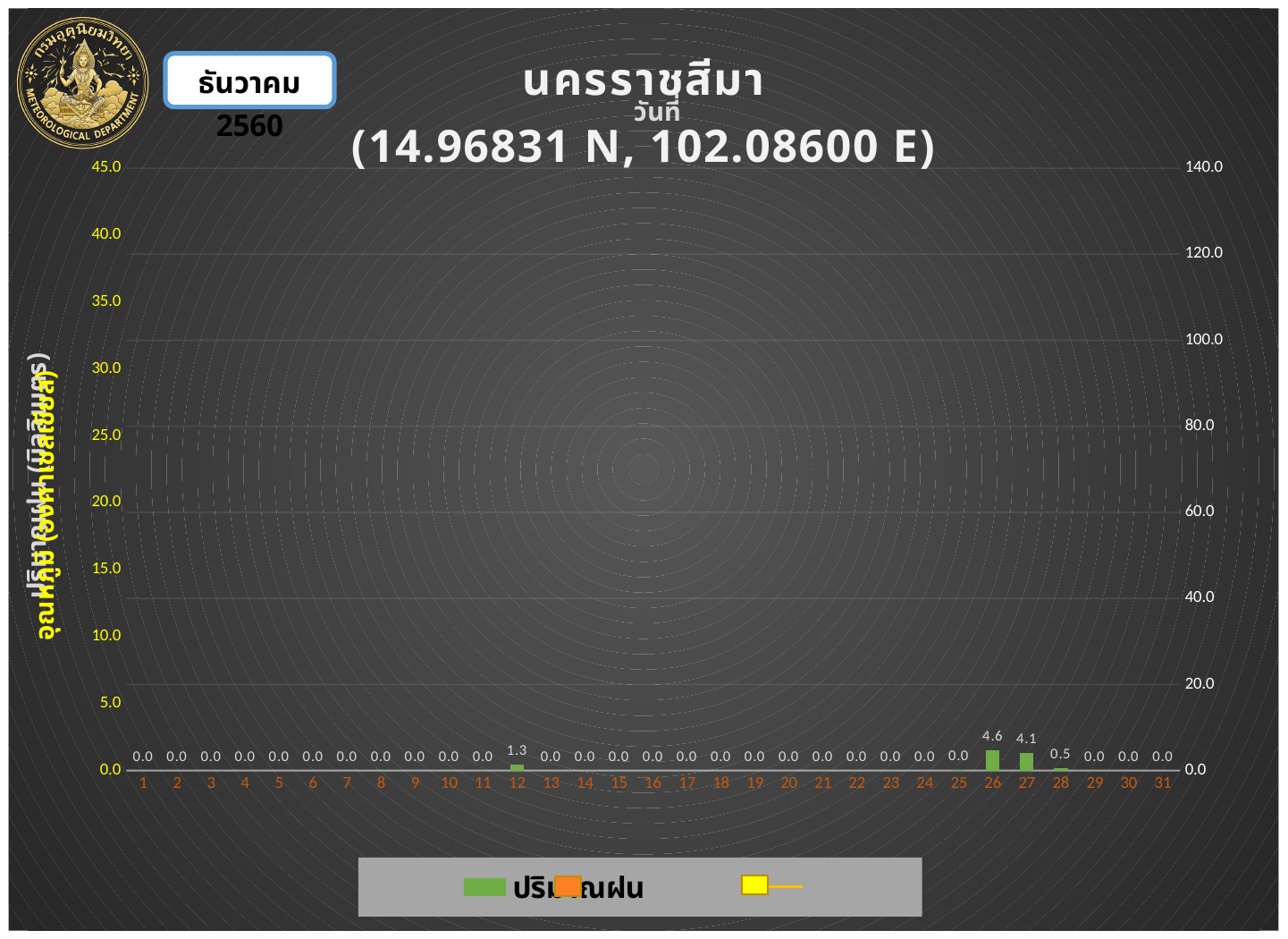
What kind of chart is used to show the rainfall values? bar chart What is the rainfall value for day 12? 1.3 How many days are shown on the x axis? 31 Which day has the highest rainfall value? 26 What is the rainfall value for day 28? 0.5 What is the difference between the rainfall values for day 26 and day 27? 0.5 Which is larger, the rainfall value for day 12 or for day 27? day 27 What is the rainfall value for day 5? 0.0 What is the rainfall value for day 26? 4.6 What is the rainfall value for day 27? 4.1 What is the difference between the rainfall values for day 12 and day 28? 0.8 What is the highest tick value shown on the right-hand y axis? 140.0